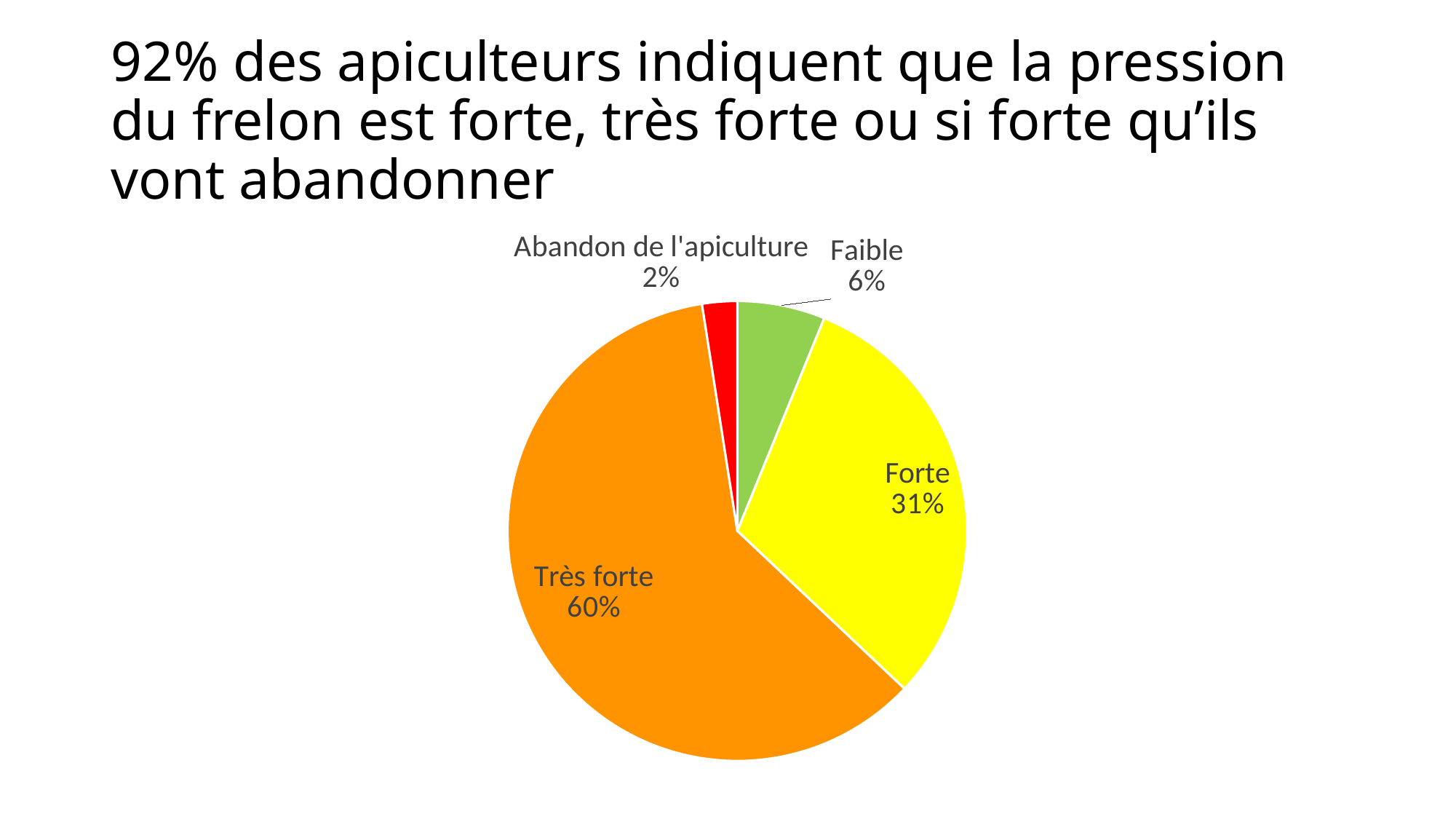
What share of the pie does "Abandon de l'apiculture" represent? 2% Which is larger, the share for "Faible" or the share for "Abandon de l'apiculture"? Faible What share of the pie does "Faible" represent? 6% Which category has the smallest slice of the pie? Abandon de l'apiculture What colour is the "Forte" slice? yellow What is the difference in percentage points between "Très forte" and "Forte"? 29 What kind of chart is shown on the slide? pie chart What share of the pie does "Très forte" represent? 60% How many slices does the pie chart have? 4 Which category has the largest slice of the pie? Très forte What is the combined share of "Forte" and "Faible"? 37%